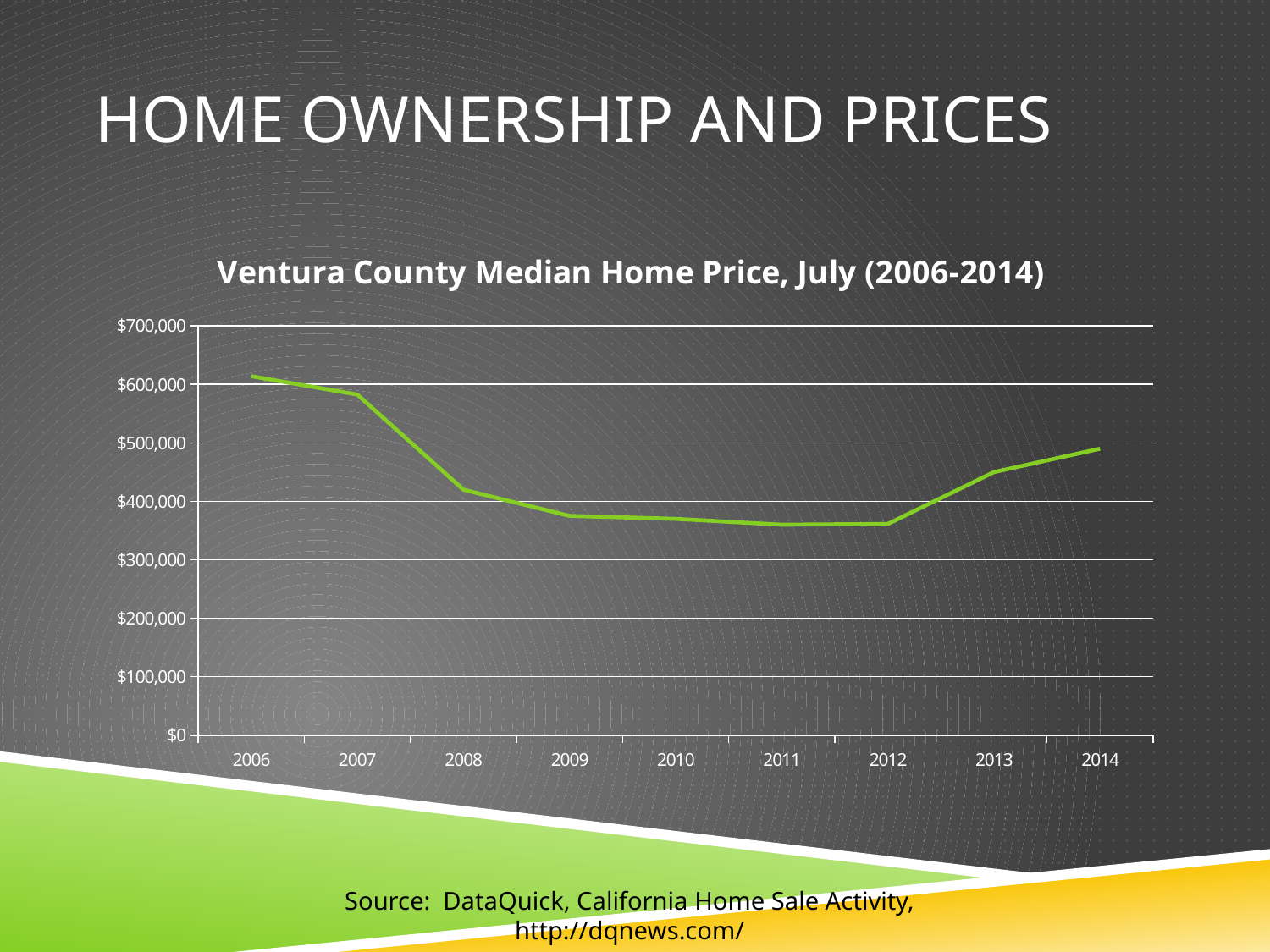
Is the value for 2008 greater or less than $400,000? greater What is the title of the chart? Ventura County Median Home Price, July (2006-2014) Which year has the highest median home price in the chart? 2006 Does the median home price rise or fall from 2012 to 2014? rise Does the median home price rise or fall from 2006 to 2012? fall Is the value for 2006 greater or less than $600,000? greater What kind of chart is shown on the slide? Line chart Which year has the larger median home price, 2006 or 2014? 2006 Is the value for 2009 greater or less than $400,000? less How many years are plotted on the x axis of the chart? 9